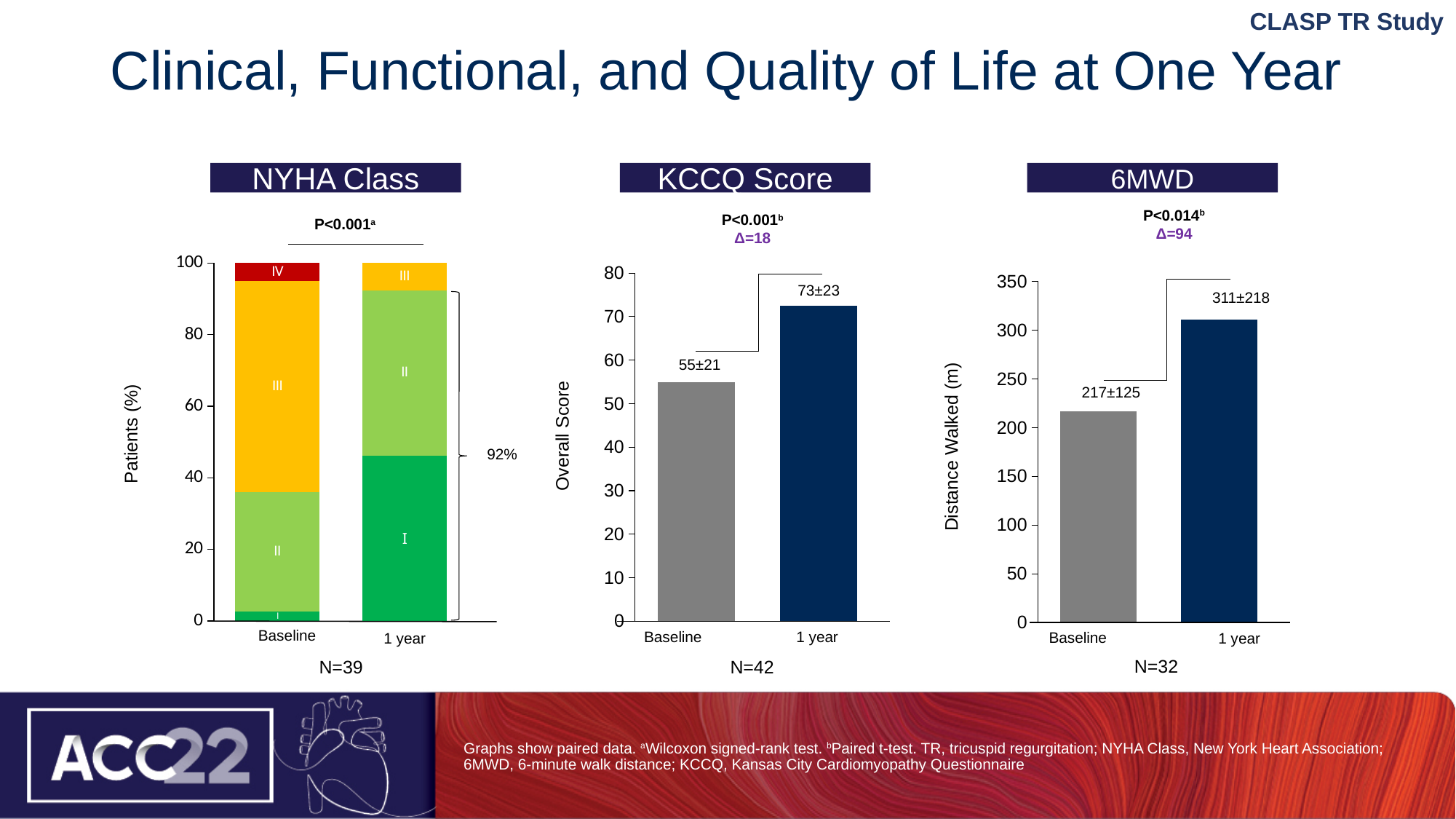
In the 6MWD chart, which bar is taller, Baseline or 1 year? 1 year In the KCCQ Score chart, is the Baseline value greater or less than 60? less In the KCCQ Score chart, what is the value shown for 1 year? 73±23 In the NYHA Class chart, how many NYHA class segments are shown in the Baseline bar? 4 In the KCCQ Score chart, do the values rise or fall from Baseline to 1 year? Rise In the 6MWD chart, what is the value shown for Baseline? 217±125 What is the y-axis label of the 6MWD chart? Distance Walked (m) In the NYHA Class chart, what percentage of patients are in Class I or II at 1 year, as annotated on the chart? 92% In the KCCQ Score chart, what is the value shown for Baseline? 55±21 In the 6MWD chart, what is the value shown for 1 year? 311±218 In the 6MWD chart, is the 1 year value greater or less than 300? greater What kind of chart is the NYHA Class chart? Stacked bar chart